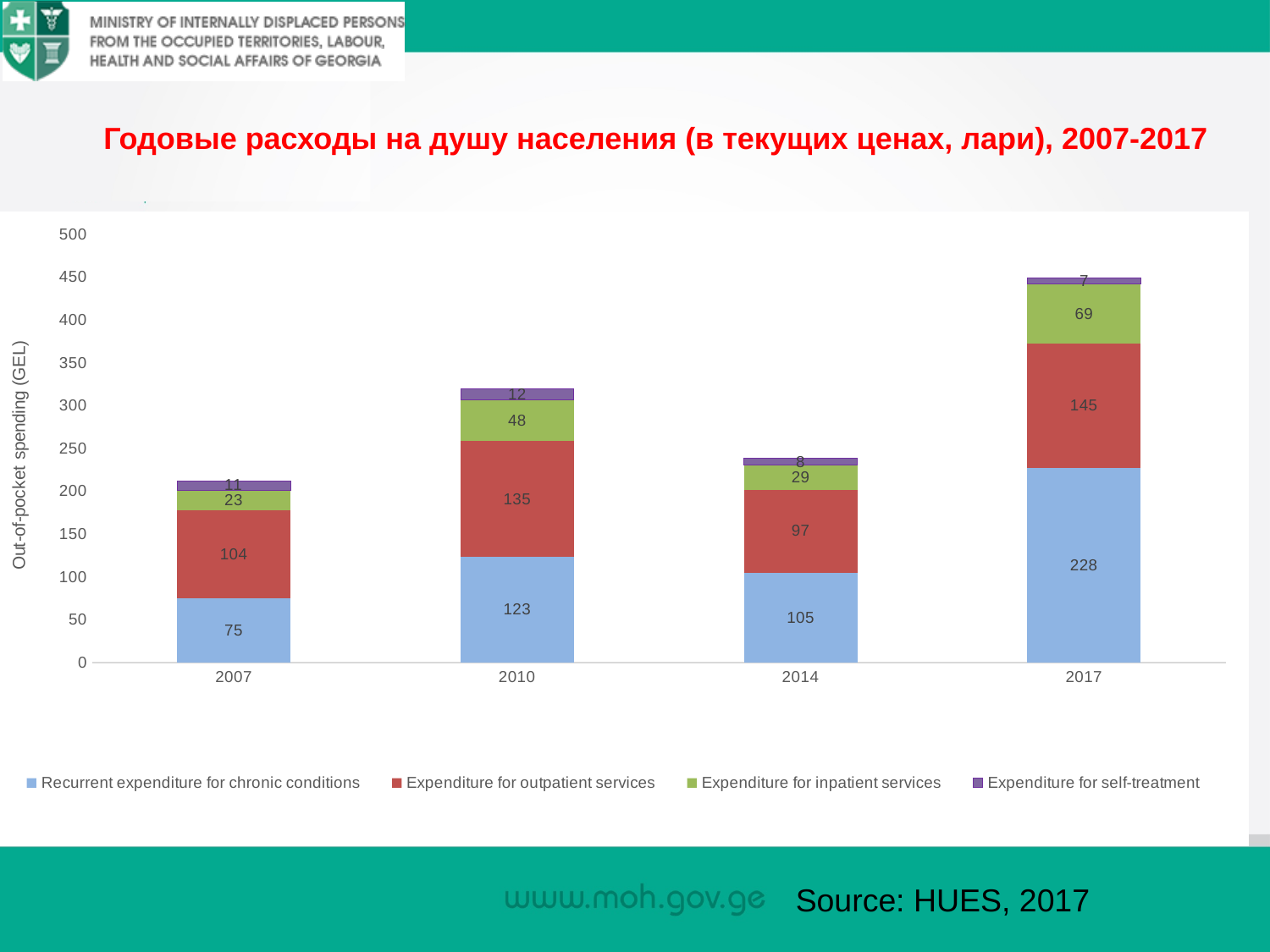
How many years are shown on the x axis? 4 What kind of chart is shown on the slide? Stacked bar chart What is the value of Expenditure for outpatient services in 2010? 135 What is the total of the stacked bar for 2010? 318 What is the value of Expenditure for self-treatment in 2007? 11 Which is larger in 2014: Recurrent expenditure for chronic conditions or Expenditure for outpatient services? Recurrent expenditure for chronic conditions In which year is Expenditure for self-treatment lowest? 2017 How many series does the legend list? 4 What is the value of Expenditure for inpatient services in 2014? 29 What is the difference between Recurrent expenditure for chronic conditions in 2017 and in 2007? 153 In which year is Expenditure for outpatient services highest? 2017 What is the value of Recurrent expenditure for chronic conditions in 2017? 228